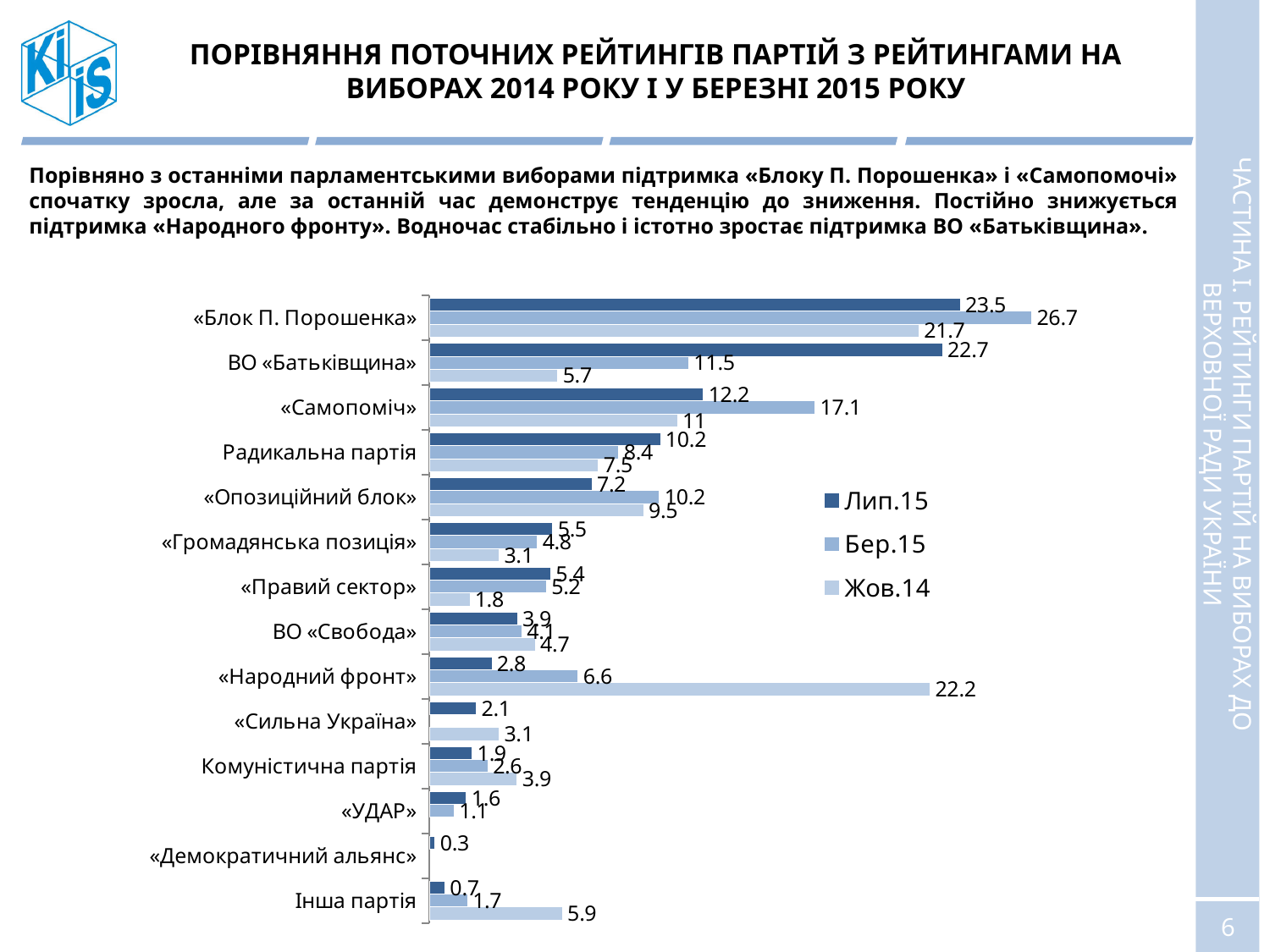
How many series does the legend list? 3 What type of chart is shown on the slide? bar chart Which party has the highest Лип.15 value? «Блок П. Порошенка» Which party has the lowest Лип.15 value? «Демократичний альянс» What is the Жов.14 value for «Народний фронт»? 22.2 What is the difference between the Лип.15 and Жов.14 values for ВО «Батьківщина»? 17 How many party categories are shown on the chart? 14 What is the Бер.15 value for «Самопоміч»? 17.1 What is the difference between the Бер.15 and Лип.15 values for «Блок П. Порошенка»? 3.2 Which legend entry is shown in the darkest blue colour? Лип.15 Which is larger for «Опозиційний блок»: the Лип.15 value or the Бер.15 value? Бер.15 What is the Лип.15 value for «Блок П. Порошенка»? 23.5